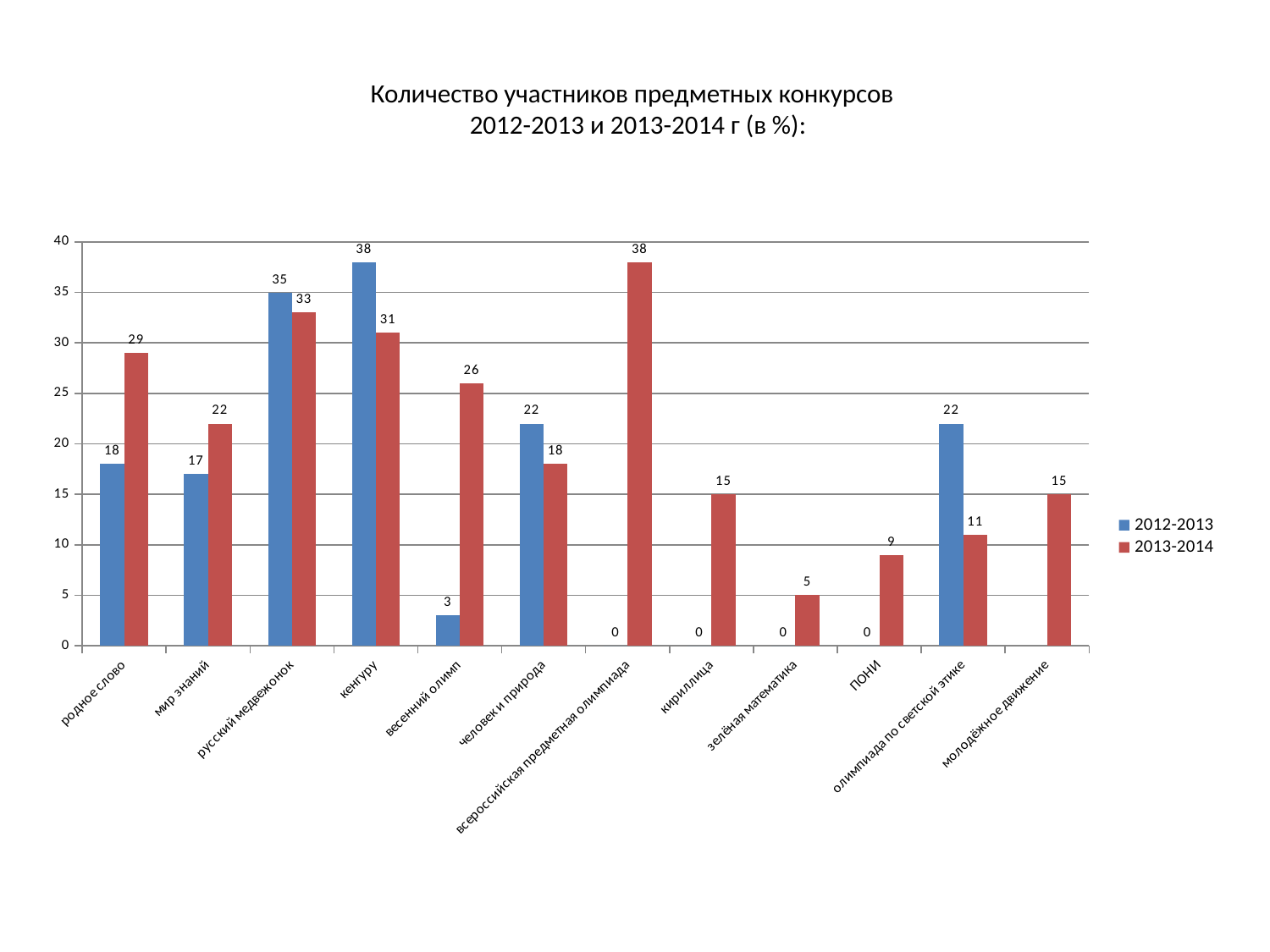
How many categories are shown on the x axis? 12 How many series does the legend list? 2 What kind of chart is shown on the slide? bar chart Which is larger for русский медвежонок: the 2012-2013 value or the 2013-2014 value? 2012-2013 What is the value for кенгуру in the 2012-2013 series? 38 What is the value for олимпиада по светской этике in the 2013-2014 series? 11 Which category has the lowest value in the 2013-2014 series? зелёная математика What are the two series named in the legend? 2012-2013 and 2013-2014 Which category has the highest value in the 2013-2014 series? всероссийская предметная олимпиада What is the difference between the 2013-2014 and 2012-2013 values for родное слово? 11 What is the value for весенний олимп in the 2013-2014 series? 26 What is the value for ПОНИ in the 2012-2013 series? 0